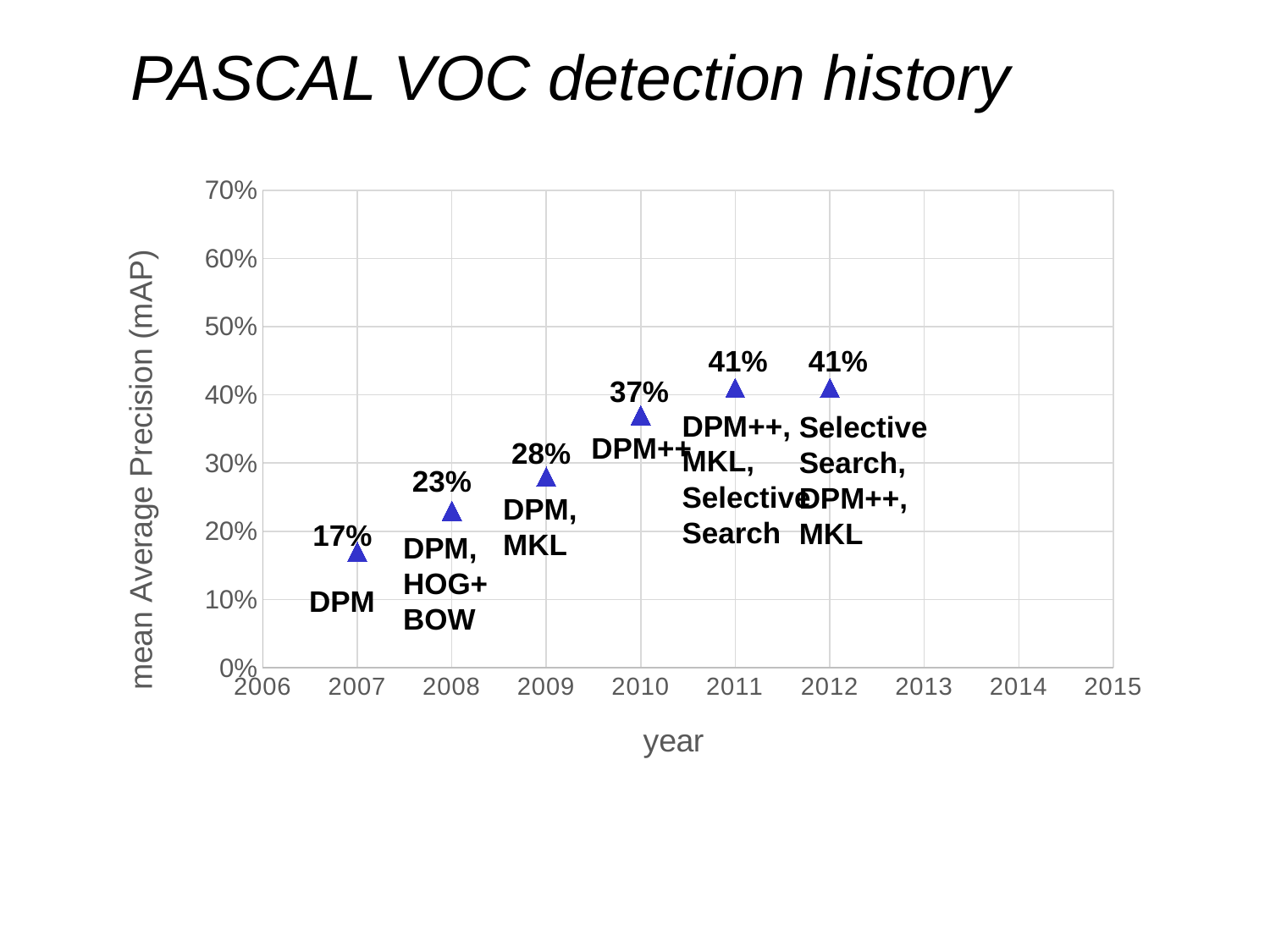
What is the difference in mAP between 2010 and 2007? 20% What method label is attached to the 2007 data point? DPM What is the difference in mAP between 2009 and 2008? 5% How many data points are plotted on the chart? 6 What is the mAP value plotted for 2009? 28% What is the mean Average Precision (mAP) value for 2007? 17% What kind of chart is this? scatter chart Do the mAP values rise or fall from 2007 to 2012? rise What is the mAP value plotted for 2010? 37% Which has a higher mAP, 2008 or 2010? 2010 Which year has the lowest mAP value? 2007 What is the title of the chart? PASCAL VOC detection history